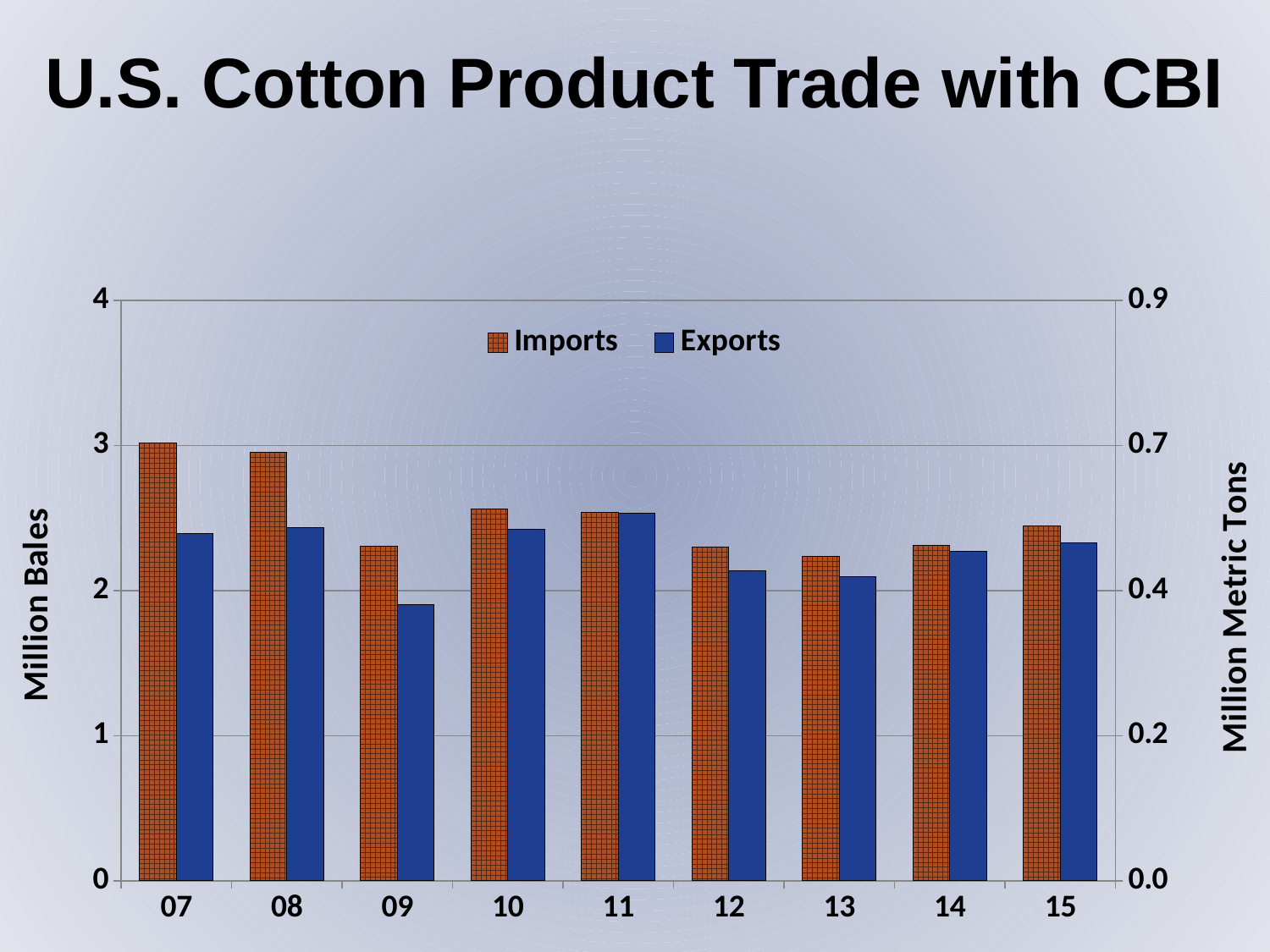
What is the title of the chart? U.S. Cotton Product Trade with CBI What is the label of the left vertical axis? Million Bales How many years are shown on the x axis? 9 Is the Imports value for 09 greater or less than 2? greater Is the Exports value for 09 greater or less than 2? less In 07, which is larger, Imports or Exports? Imports Which year has the highest Imports value? 07 Do the Imports values rise or fall from 07 to 09? fall What kind of chart is shown on the slide? bar chart How many series does the legend list? 2 Which year has the lowest Exports value? 09